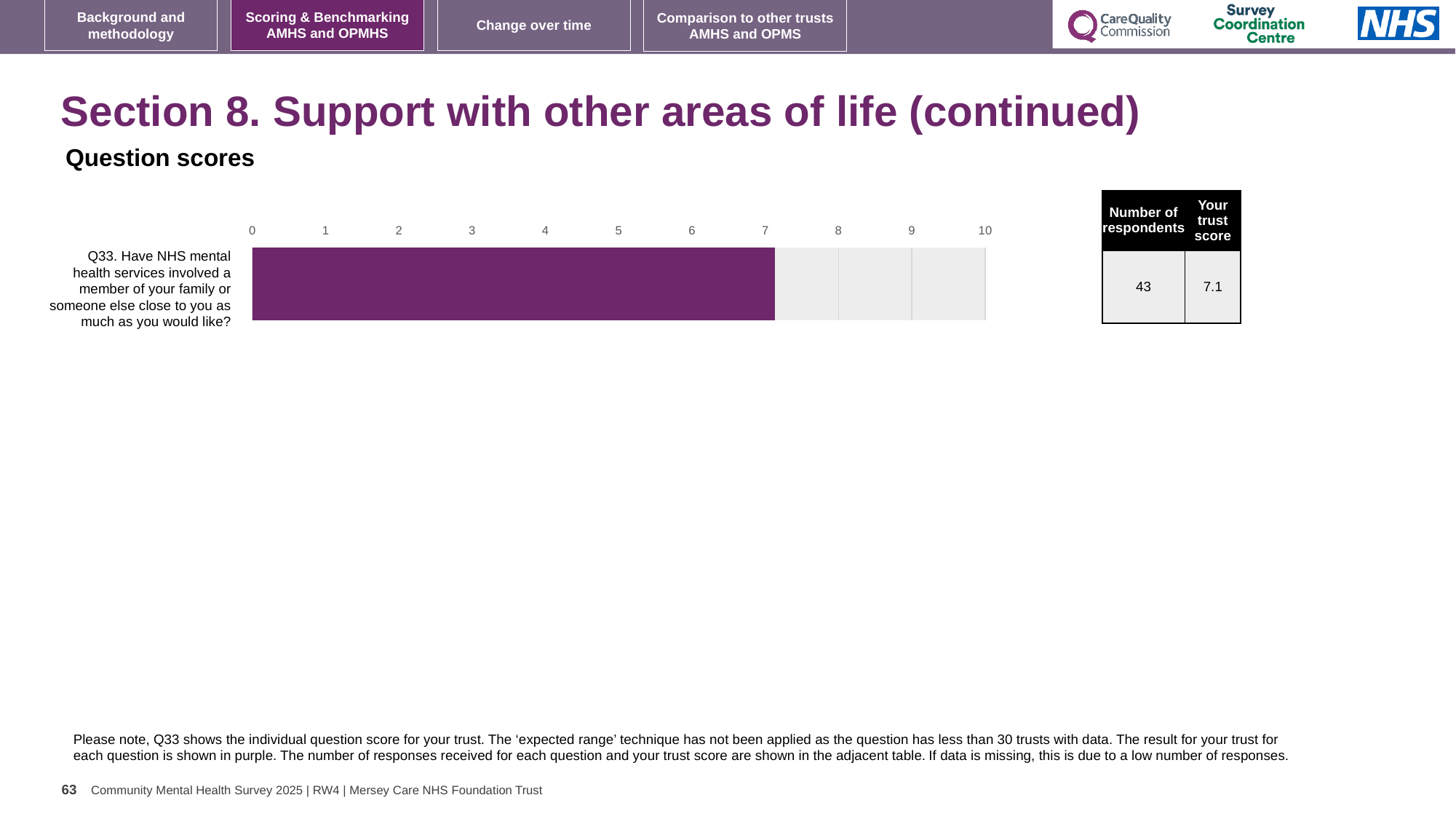
What colour is the bar representing the trust's result for Q33? purple What is the trust score for Q33 shown in the adjacent table? 7.1 How many questions (categories) are plotted in the chart? 1 Is the value of the bar for Q33 greater or less than 5? greater What kind of chart is shown on the slide? bar chart Is the value of the bar for Q33 greater or less than 7? greater How many respondents are listed for Q33 in the table next to the chart? 43 What is the maximum value shown on the chart's horizontal axis? 10 Is the value of the bar for Q33 greater or less than 8? less